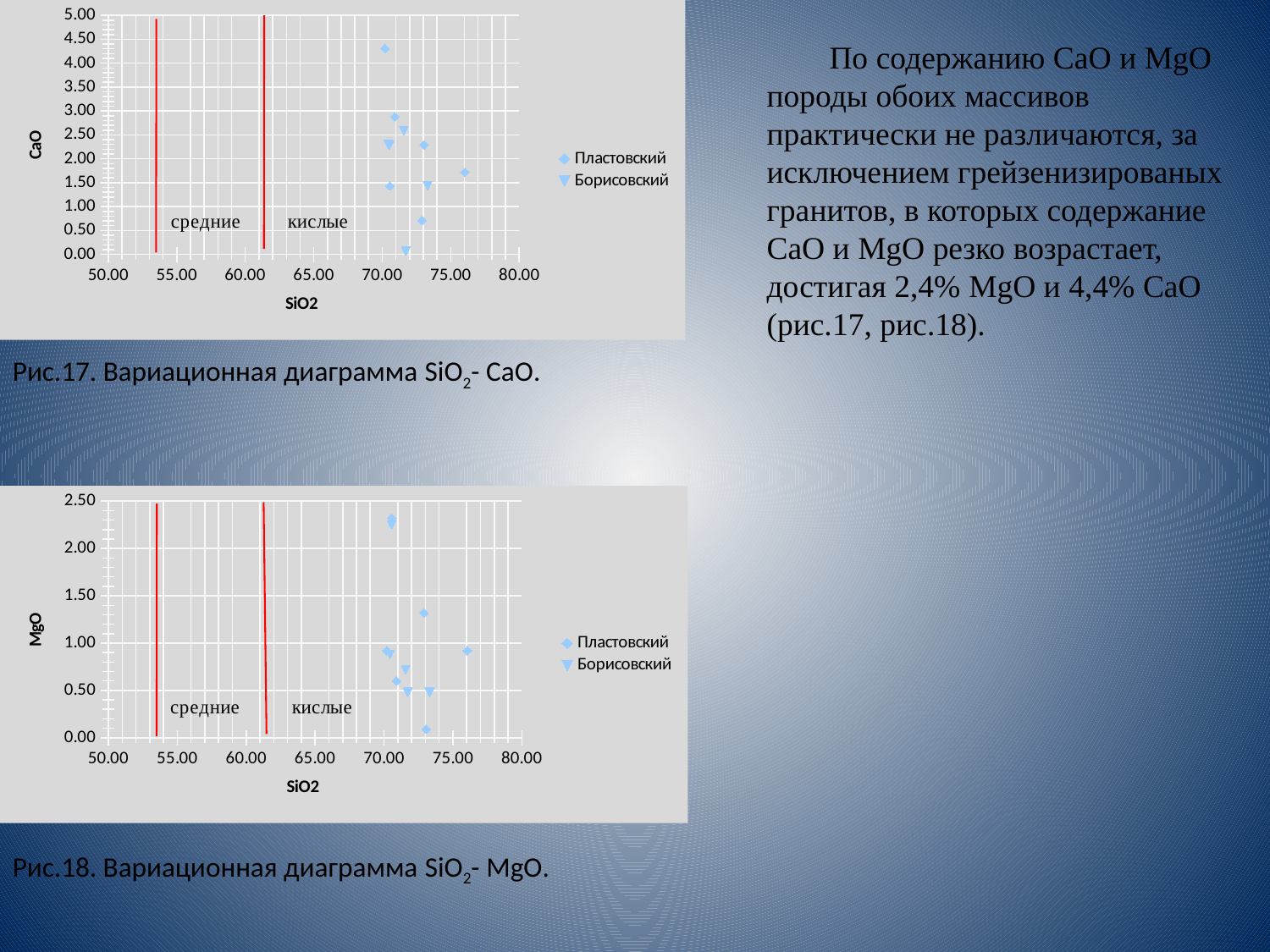
In the top chart (Рис.17), are all plotted points at SiO2 values greater or less than 65.00? greater In the top chart (Рис.17), is the highest CaO value plotted greater or less than 4.50? less What kind of chart is the top chart (Рис.17)? scatter chart What is the maximum value shown on the y-axis of the bottom chart (Рис.18)? 2.50 What are the two series named in the legend of the bottom chart (Рис.18)? Пластовский, Борисовский In the top chart (Рис.17), is the highest CaO value plotted greater or less than 4.00? greater How many series does the legend of the top chart (Рис.17) list? 2 What is the maximum value shown on the y-axis of the top chart (Рис.17)? 5.00 What is the y-axis title of the bottom chart (Рис.18)? MgO